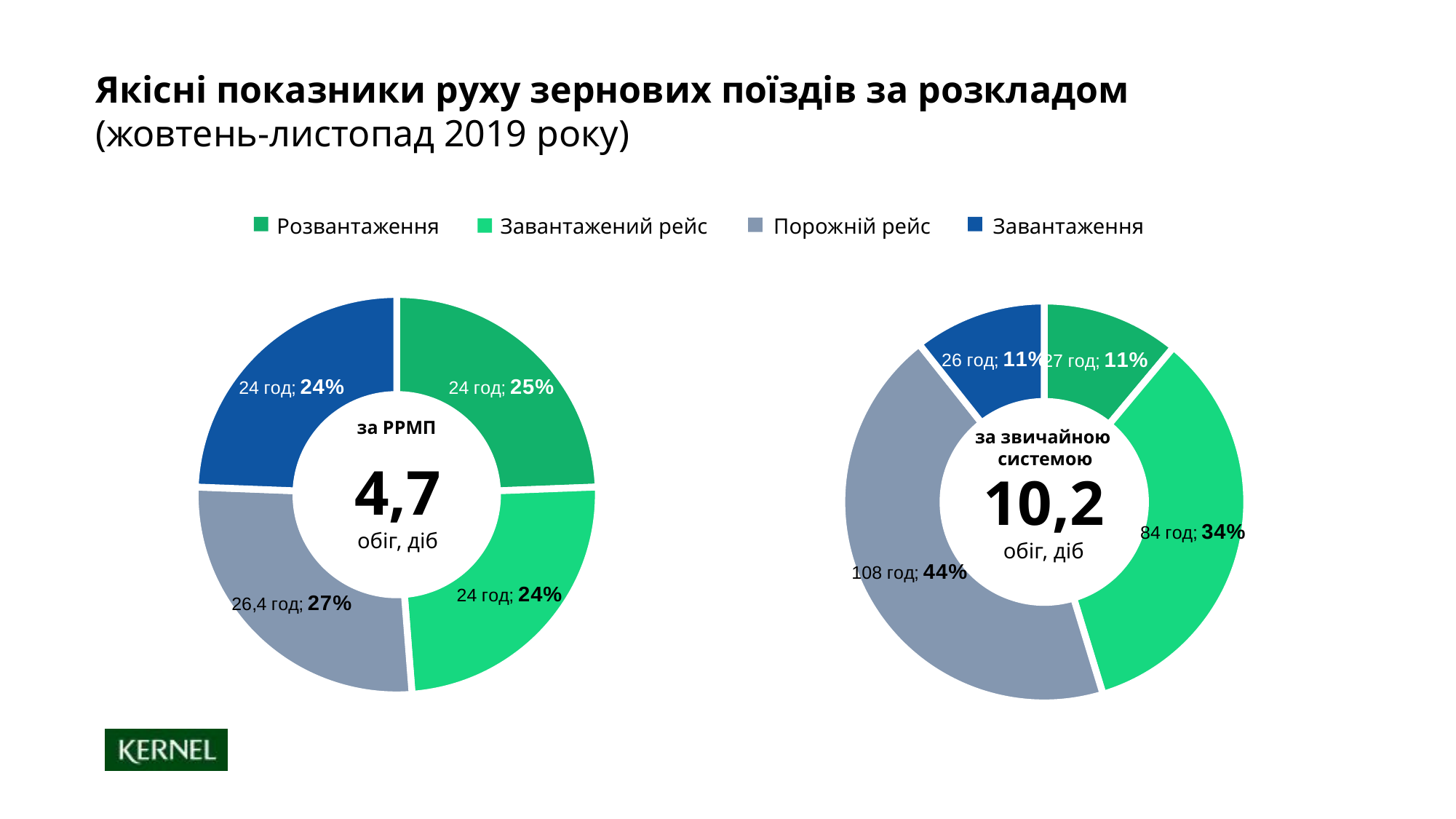
What type of chart is used on this slide? Donut (pie) chart In the left chart (за РРМП), which segment has the largest share? Порожній рейс How many series does the legend list? 4 In the left chart (за РРМП), what is the value shown for Порожній рейс? 26,4 год; 27% In the right chart (за звичайною системою), which segment has the largest share? Порожній рейс In the right chart (за звичайною системою), how many hours are shown for Порожній рейс? 108 год What turnover value in days (обіг, діб) is shown in the centre of the right chart (за звичайною системою)? 10,2 In the right chart (за звичайною системою), what is the difference in hours between Порожній рейс and Завантажений рейс? 24 год In the right chart (за звичайною системою), what percentage share does Розвантаження have? 11% In the right chart (за звичайною системою), what is the value shown for Завантажений рейс? 84 год; 34% How many segments does each donut chart have? 4 In the right chart (за звичайною системою), which is larger in hours: Завантажений рейс or Завантаження? Завантажений рейс